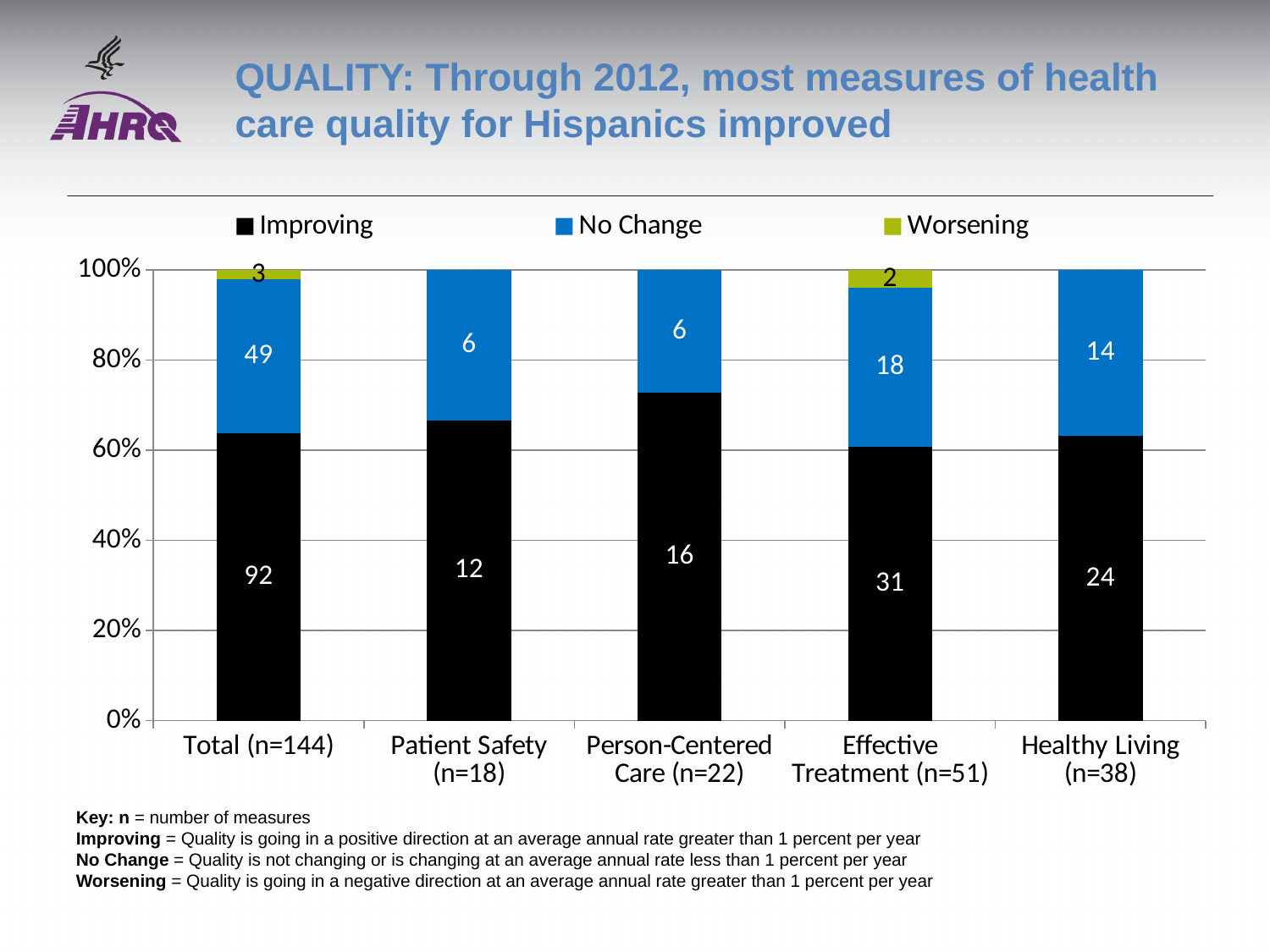
Excluding Total, which category has the lowest number of Improving measures? Patient Safety (n=18) How many series does the legend list? 3 Which category has the highest number of Improving measures? Total (n=144) What is the total of the Improving and No Change measures for Patient Safety (n=18)? 18 How many categories are shown on the x axis? 5 What is the difference between the Improving and No Change measures for Effective Treatment (n=51)? 13 Which has more Improving measures, Person-Centered Care (n=22) or Healthy Living (n=38)? Healthy Living (n=38) What is the number of No Change measures for Effective Treatment (n=51)? 18 What kind of chart is shown on the slide? Stacked bar chart What is the number of Improving measures for Healthy Living (n=38)? 24 What is the number of Improving measures for Total (n=144)? 92 What is the number of Worsening measures for Total (n=144)? 3